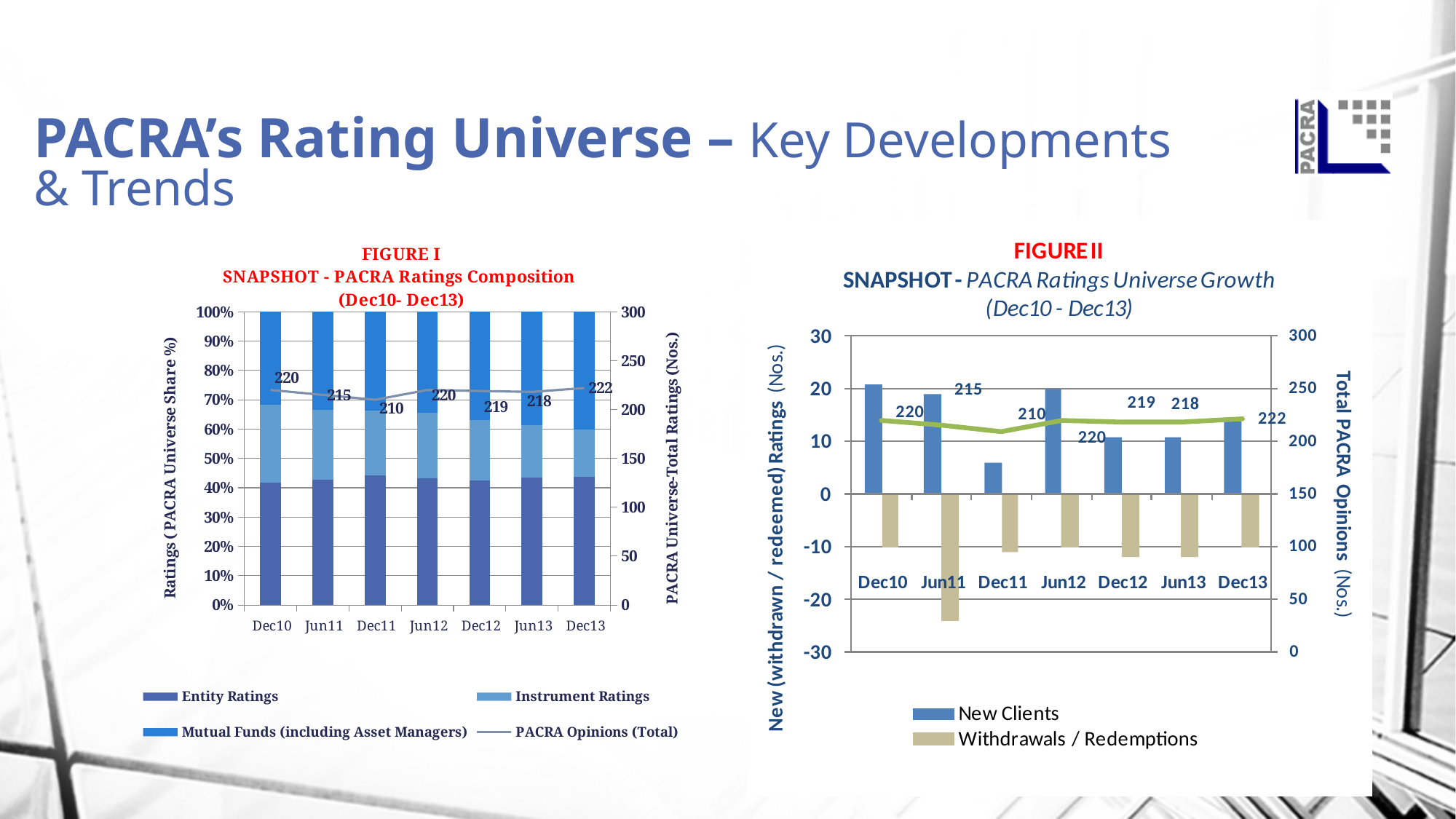
In Figure I, which period has the lowest PACRA Opinions (Total) value? Dec11 In Figure II, what is the Total PACRA Opinions value for Jun12? 220 In Figure II, which period has the lowest New Clients value? Dec11 In Figure I, how many entries does the legend list? 4 In Figure I, which period has the highest PACRA Opinions (Total) value? Dec13 In Figure I, what is the difference between the PACRA Opinions (Total) values for Dec13 and Dec11? 12 In Figure I, what is the PACRA Opinions (Total) value for Dec11? 210 In Figure II, is the New Clients value for Dec11 greater or less than 10? less In Figure I, how many periods are shown on the x axis? 7 In Figure II, which period has the largest Withdrawals / Redemptions bar? Jun11 What kind of chart is Figure I? Bar chart (stacked) with a line In Figure II, how many series does the legend list? 2